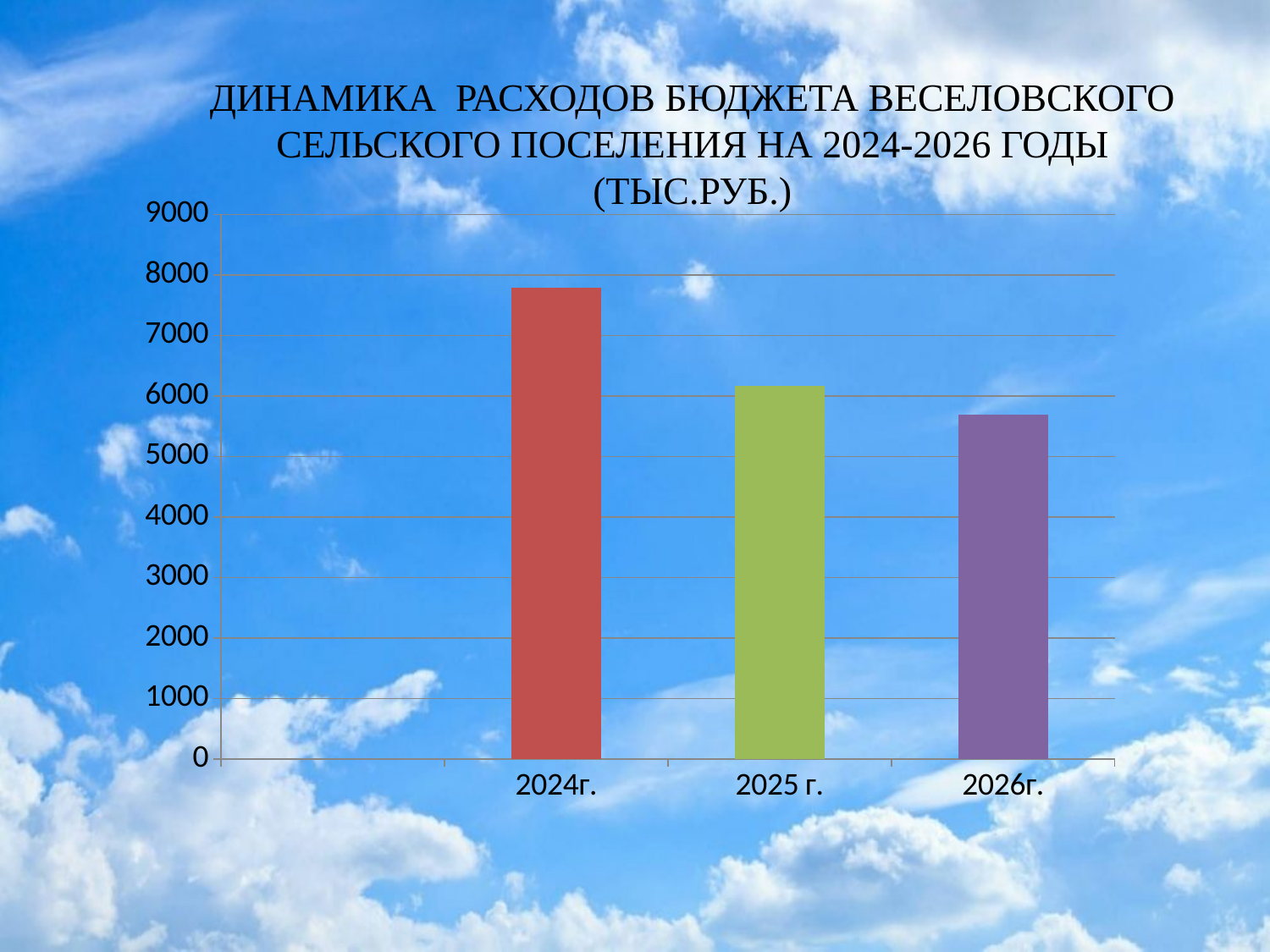
Which is larger, the value for 2025 г. or the value for 2026г.? 2025 г. Do the values rise or fall from 2024г. to 2026г.? fall Which is larger, the value for 2024г. or the value for 2025 г.? 2024г. Is the value for 2024г. greater or less than 7000? greater Is the value for 2026г. greater or less than 6000? less What colour is the bar for 2025 г.? green Is the value for 2024г. greater or less than 8000? less What kind of chart is shown on the slide? bar chart Which year has the lowest budget expenditure in the chart? 2026г. How many years (categories) are shown in the chart? 3 Which year has the highest budget expenditure in the chart? 2024г.